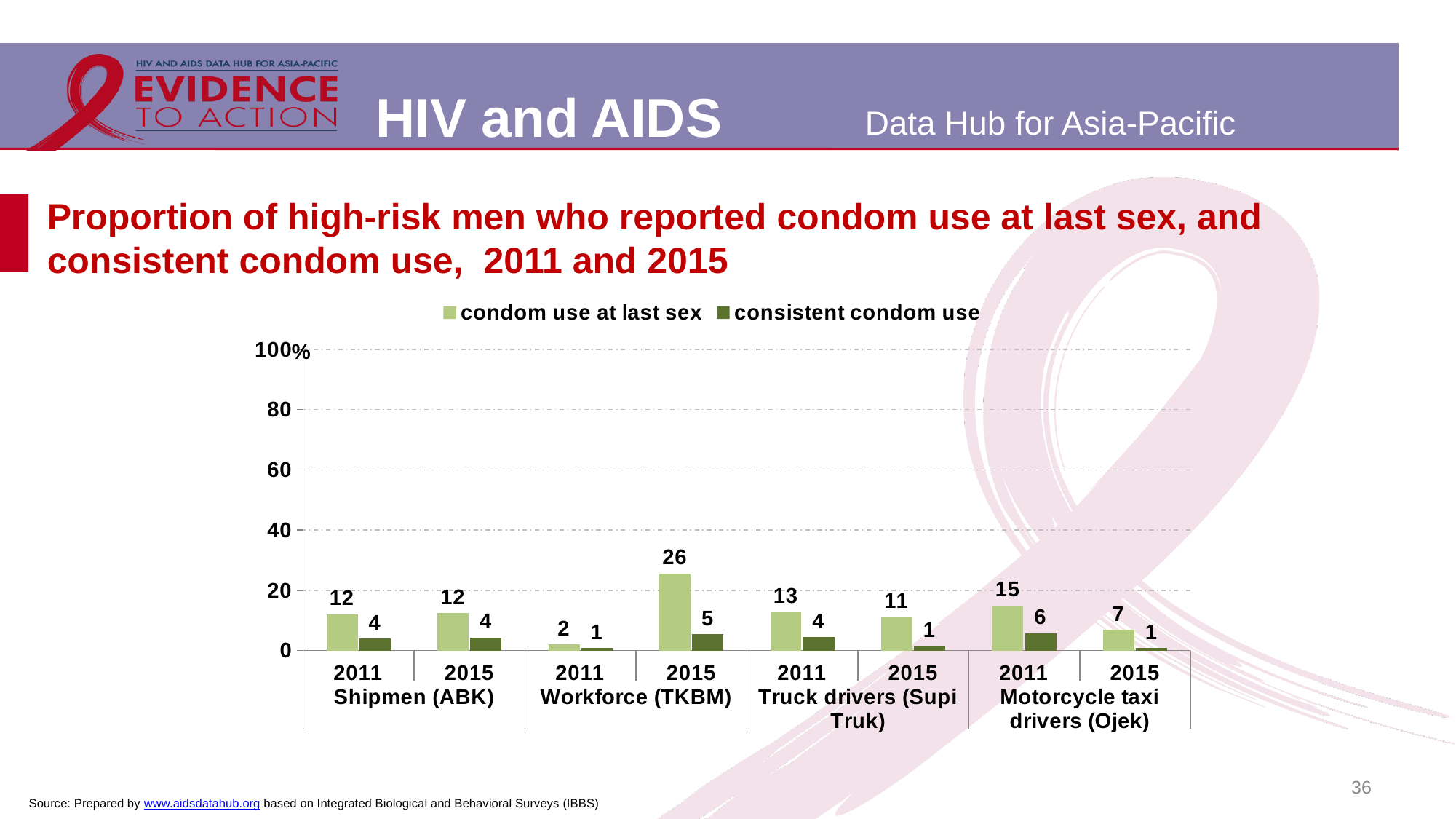
What is the value for condom use at last sex among Truck drivers (Supi Truk) in 2011? 13 How many series does the legend list? 2 How did condom use at last sex among Shipmen (ABK) change from 2011 to 2015? It stayed the same at 12 What is the value for condom use at last sex among Workforce (TKBM) in 2015? 26 Which is larger: condom use at last sex for Truck drivers (Supi Truk) in 2011 or in 2015? 2011 What is the difference in condom use at last sex for Motorcycle taxi drivers (Ojek) between 2011 and 2015? 8 What kind of chart is shown on the slide? bar chart What is the difference between condom use at last sex and consistent condom use for Workforce (TKBM) in 2015? 21 Which group and year has the highest value for condom use at last sex? Workforce (TKBM) 2015 Which group and year has the lowest value for condom use at last sex? Workforce (TKBM) 2011 What is the value for consistent condom use among Motorcycle taxi drivers (Ojek) in 2011? 6 Is the value for condom use at last sex among Workforce (TKBM) in 2015 greater or less than 20? greater